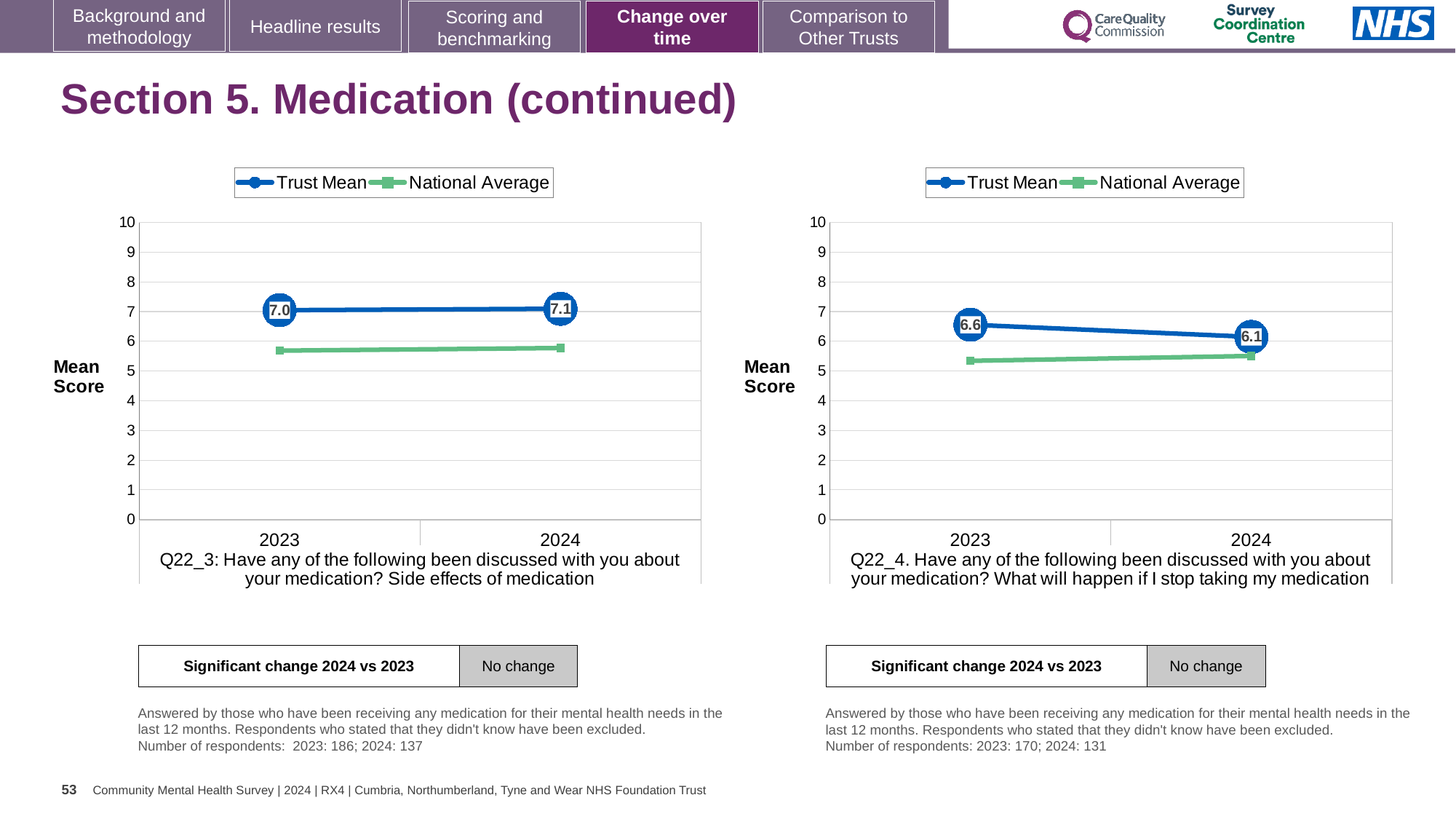
In the right chart (Q22_4), by how much did the Trust Mean change from 2023 to 2024? 0.5 In the right chart (Q22_4), is the National Average for 2024 greater or less than 6? less In the left chart (Q22_3), which is larger in 2024, the Trust Mean or the National Average? Trust Mean What kind of chart is the right chart (Q22_4)? line chart In the right chart (Q22_4), does the Trust Mean rise or fall from 2023 to 2024? fall How many series does the legend of the left chart (Q22_3) list? 2 In the left chart (Q22_3), what is the Trust Mean score for 2023? 7.0 In the right chart (Q22_4), what is the Trust Mean score for 2023? 6.6 In the left chart (Q22_3), is the National Average for 2023 greater or less than 6? less How many years are shown on the x axis of the left chart (Q22_3)? 2 In the right chart (Q22_4), what is the Trust Mean score for 2024? 6.1 In the left chart (Q22_3), what is the Trust Mean score for 2024? 7.1